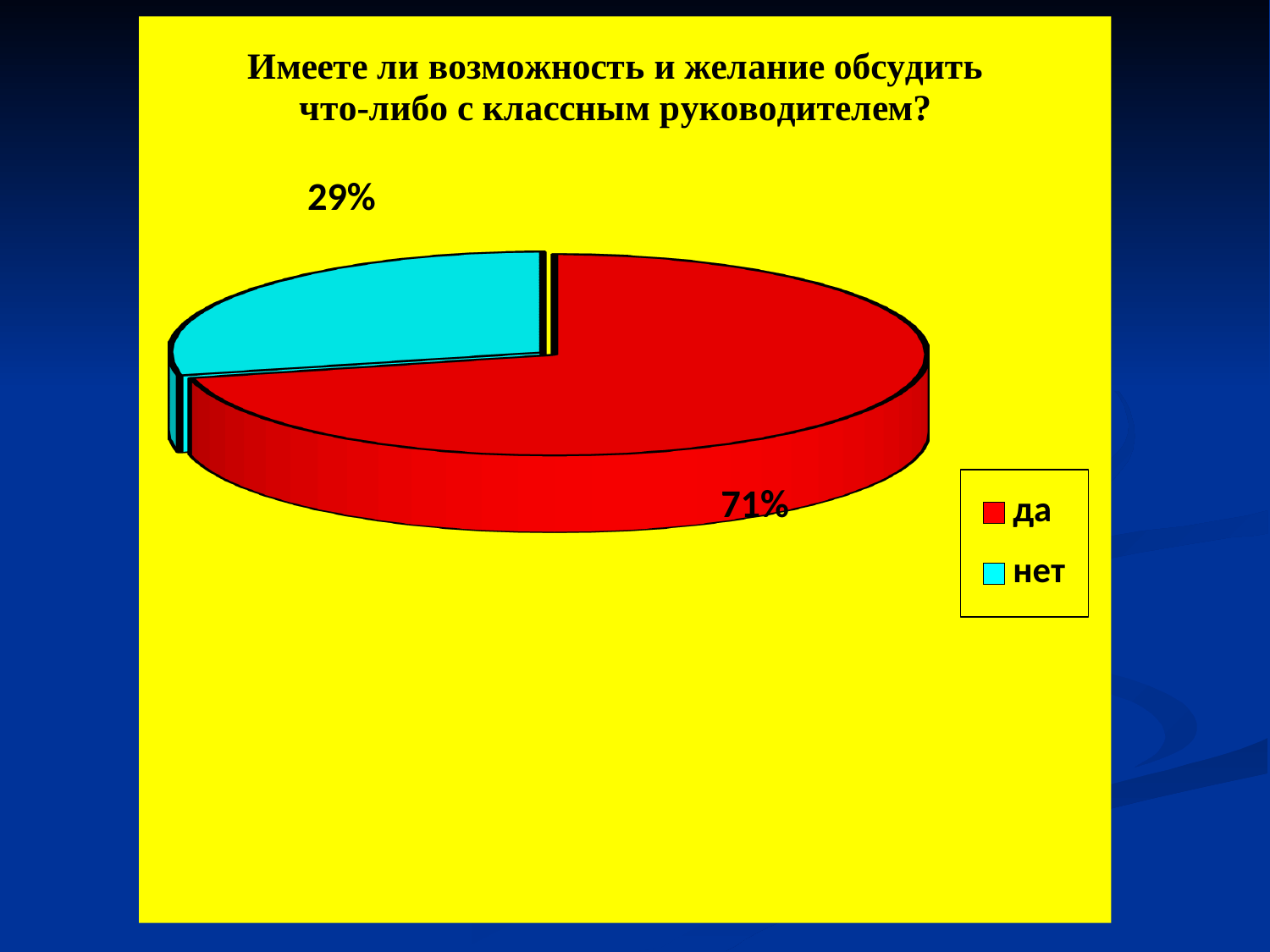
Which slice is the smallest? нет What is the difference in percentage points between the "да" and "нет" slices? 42 What share of the pie does "нет" take? 29% What share of the pie does "да" take? 71% Which is larger, the "да" slice or the "нет" slice? да How many entries does the legend list? 2 Which slice is the largest? да What kind of chart is shown on the slide? pie chart How many slices does the pie chart have? 2 What is the title of the chart? Имеете ли возможность и желание обсудить что-либо с классным руководителем? What colour is the "нет" slice? cyan